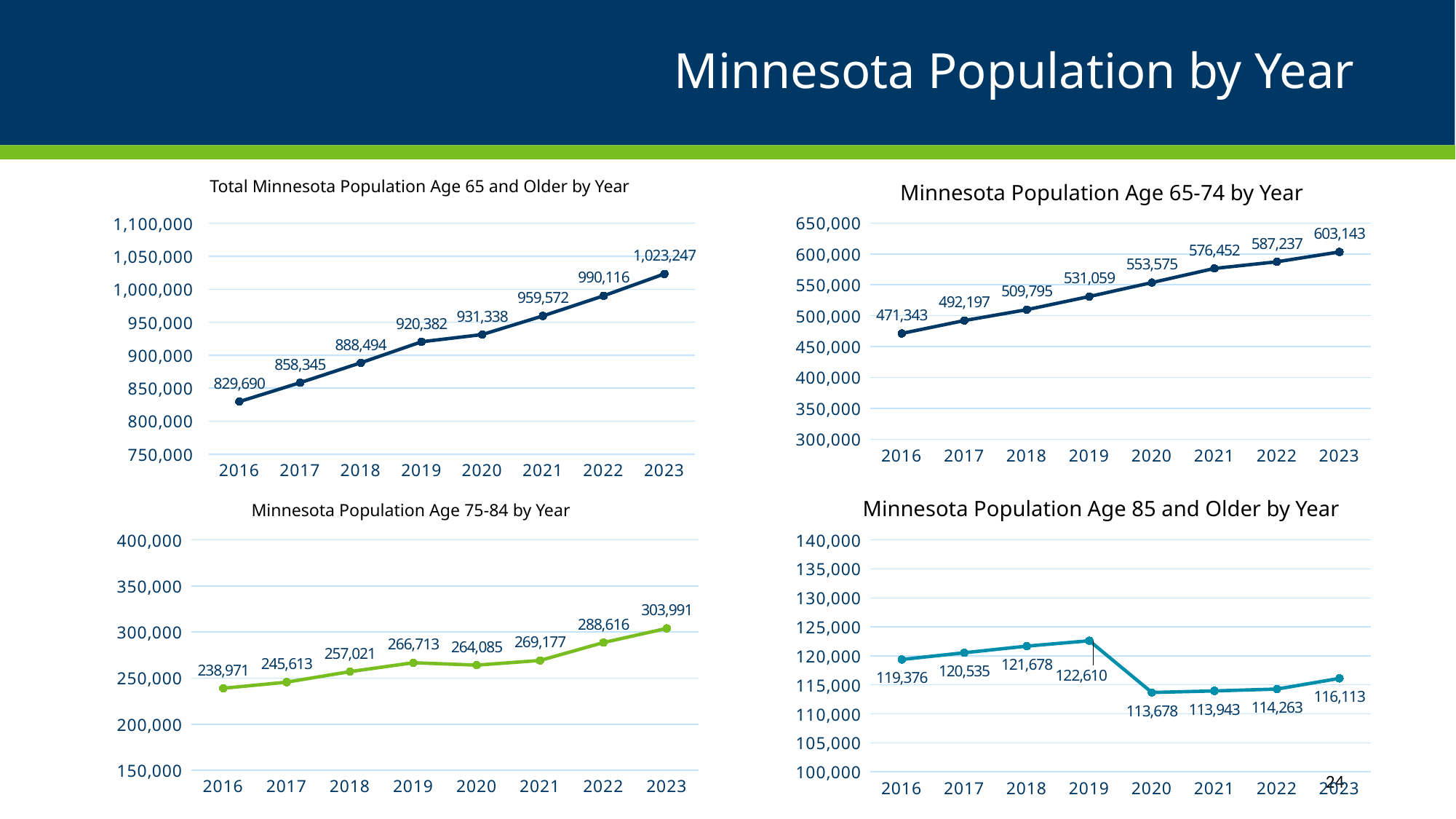
In the 'Minnesota Population Age 85 and Older by Year' chart, by how much did the value drop from 2019 to 2020? 8,932 In the 'Minnesota Population Age 75-84 by Year' chart, which is larger, the value for 2019 or the value for 2020? 2019 In the 'Minnesota Population Age 85 and Older by Year' chart, which year has the highest value? 2019 In the 'Total Minnesota Population Age 65 and Older by Year' chart, what is the difference between the 2023 and 2016 values? 193,557 In the 'Minnesota Population Age 65-74 by Year' chart, is the value for 2023 greater or less than 600,000? greater In the 'Total Minnesota Population Age 65 and Older by Year' chart, what is the value for 2023? 1,023,247 In the 'Minnesota Population Age 65-74 by Year' chart, do the values rise or fall from 2016 to 2023? Rise How many years are plotted in the 'Minnesota Population Age 65-74 by Year' chart? 8 In the 'Minnesota Population Age 85 and Older by Year' chart, which year has the lowest value? 2020 In the 'Minnesota Population Age 65-74 by Year' chart, what is the value for 2019? 531,059 In the 'Minnesota Population Age 75-84 by Year' chart, what is the value for 2020? 264,085 What kind of chart is 'Minnesota Population Age 75-84 by Year'? Line chart